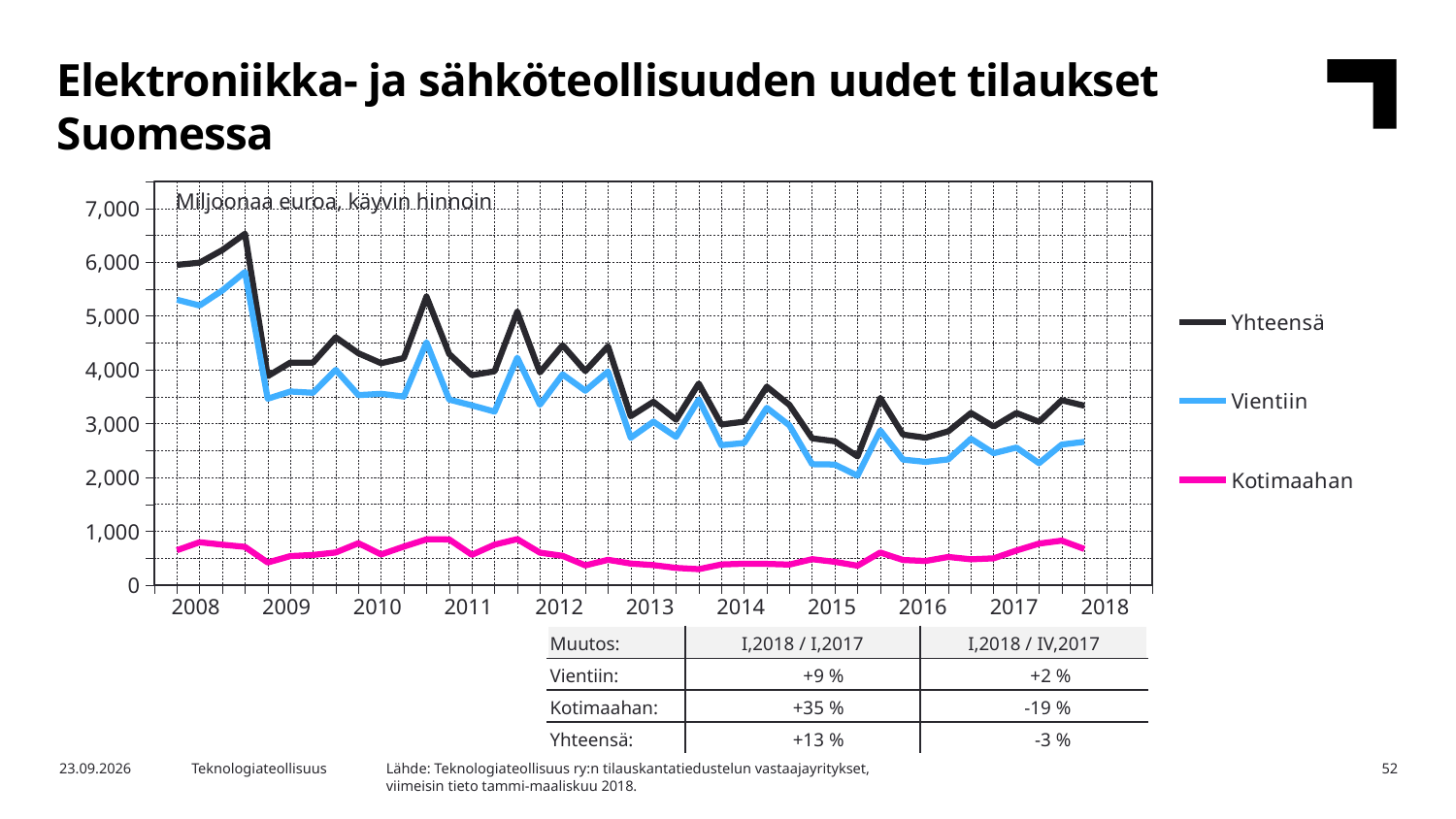
Which series has the lowest values throughout the chart? Kotimaahan How many series does the legend list? 3 What unit is stated at the top of the chart area? Miljoonaa euroa, käyvin hinnoin Which series is larger in 2015, Vientiin or Kotimaahan? Vientiin Is the value for Kotimaahan at any point greater or less than 1,000? less Does the Yhteensä series overall rise or fall from 2008 to 2018? fall How many year labels are shown on the x axis? 11 Which series has the highest values throughout the chart? Yhteensä Is the peak value of Yhteensä in 2008 greater or less than 6,000? greater What kind of chart is shown on the slide? line chart Which series is shown in pink in the chart? Kotimaahan Is the value for Vientiin at the start of 2018 greater or less than 2,000? greater